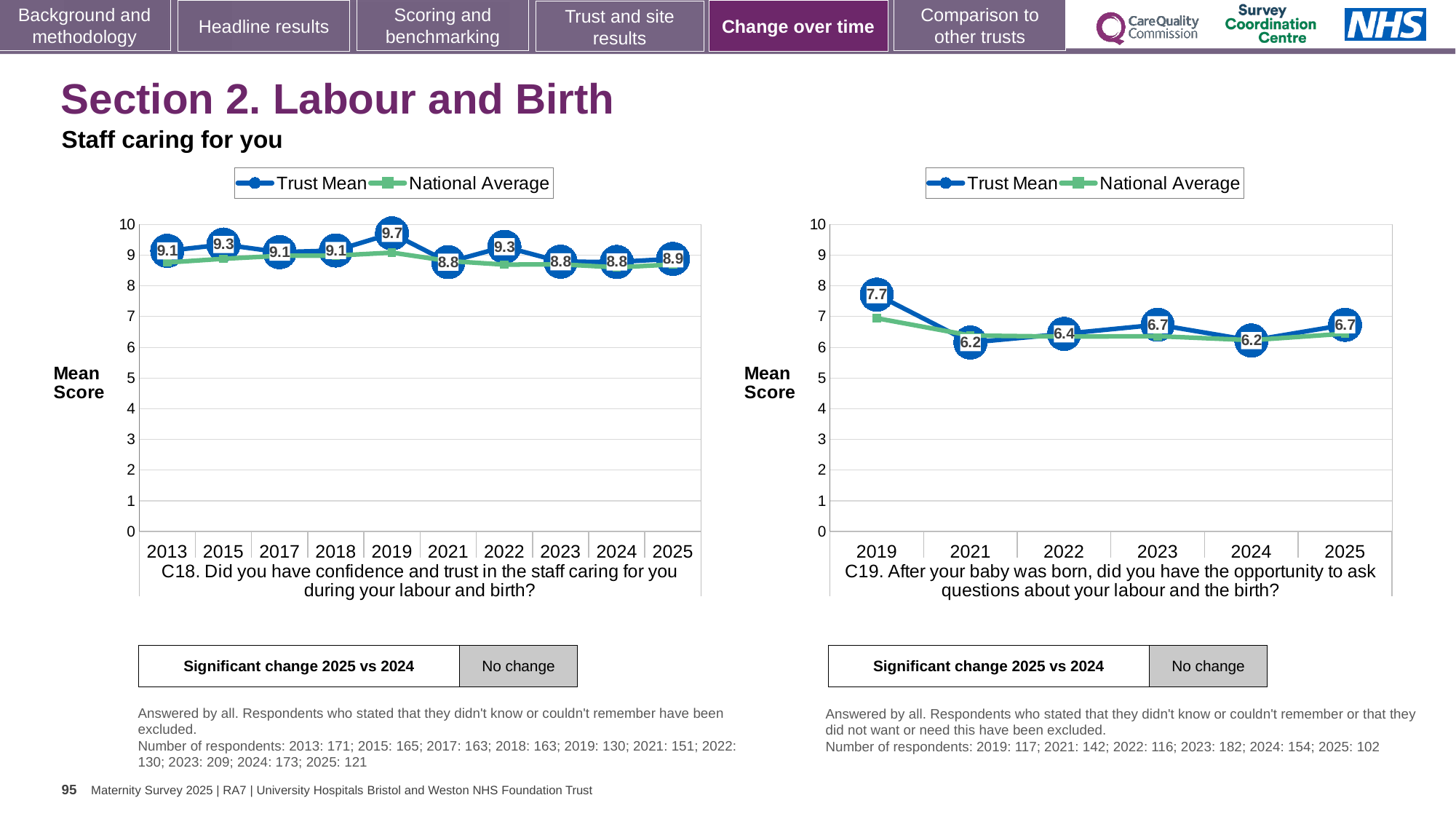
In the C19 chart (right), what is the Trust Mean for 2019? 7.7 In the C19 chart (right), is the National Average for 2019 greater or less than 6? greater In the C19 chart (right), what is the difference between the Trust Mean in 2019 and in 2021? 1.5 In the C18 chart (left), how many years are plotted on the x axis? 10 In the C19 chart (right), what is the Trust Mean for 2023? 6.7 How many series does the legend of the C18 chart (left) list? 2 In the C18 chart (left), what is the Trust Mean for 2019? 9.7 In the C19 chart (right), which year has the highest Trust Mean? 2019 In the C19 chart (right), is the Trust Mean for 2019 greater or less than the Trust Mean for 2024? greater In the C18 chart (left), which year has the highest Trust Mean? 2019 In the C18 chart (left), what is the difference between the Trust Mean in 2019 and in 2021? 0.9 In the C18 chart (left), what is the Trust Mean for 2025? 8.9